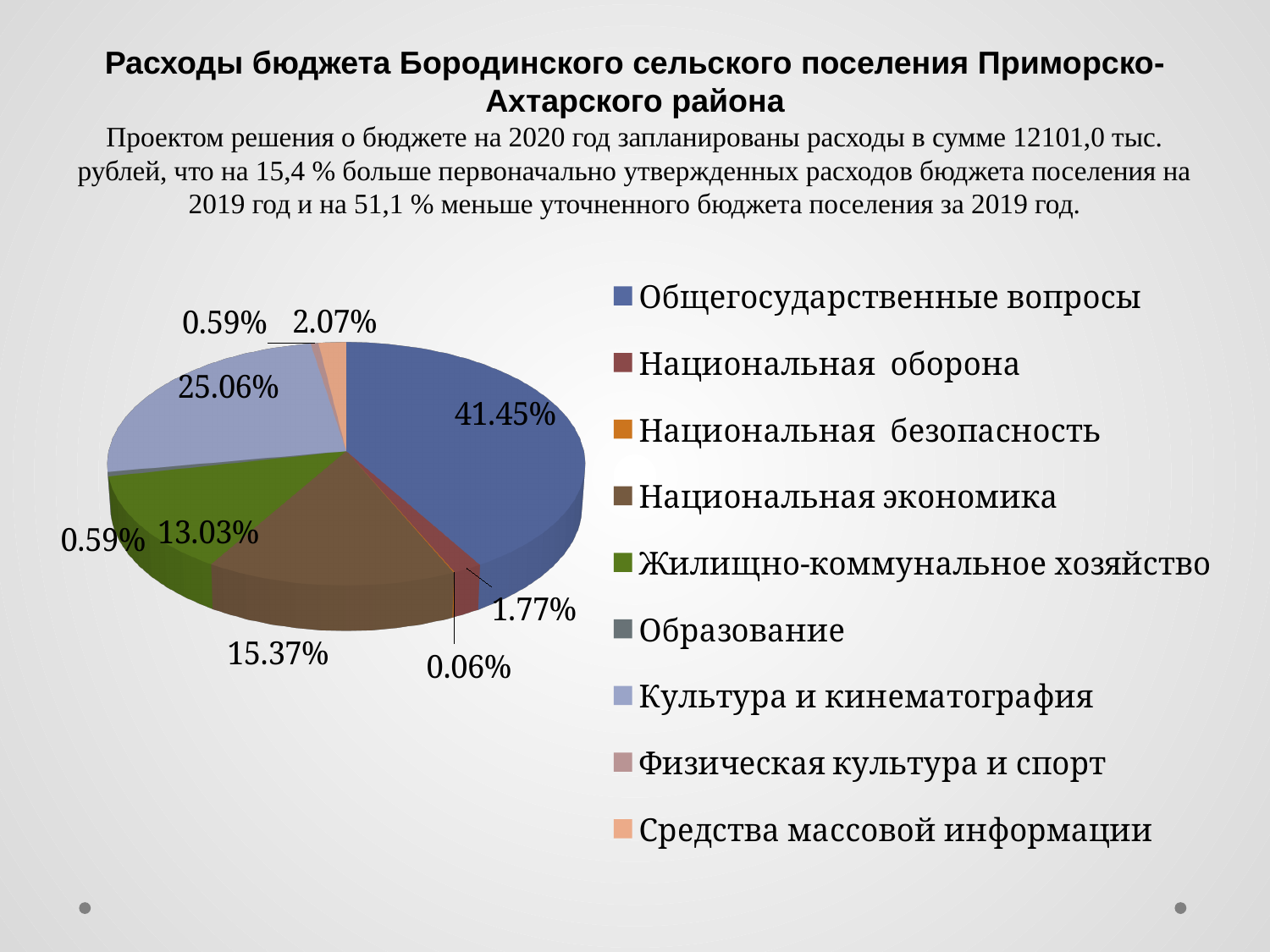
What kind of chart is shown on the slide? Pie chart What share of the pie does Национальная оборона represent? 1.77% What share of the pie does Средства массовой информации represent? 2.07% How many categories does the legend list? 9 What share of the pie does Общегосударственные вопросы represent? 41.45% Which is larger: the share for Национальная экономика or the share for Жилищно-коммунальное хозяйство? Национальная экономика Which category has the smallest share of the pie? Национальная безопасность What share of the pie does Национальная экономика represent? 15.37% What share of the pie does Жилищно-коммунальное хозяйство represent? 13.03% Which category has the largest share of the pie? Общегосударственные вопросы What is the difference in percentage points between Общегосударственные вопросы and Культура и кинематография? 16.39 What share of the pie does Культура и кинематография represent? 25.06%